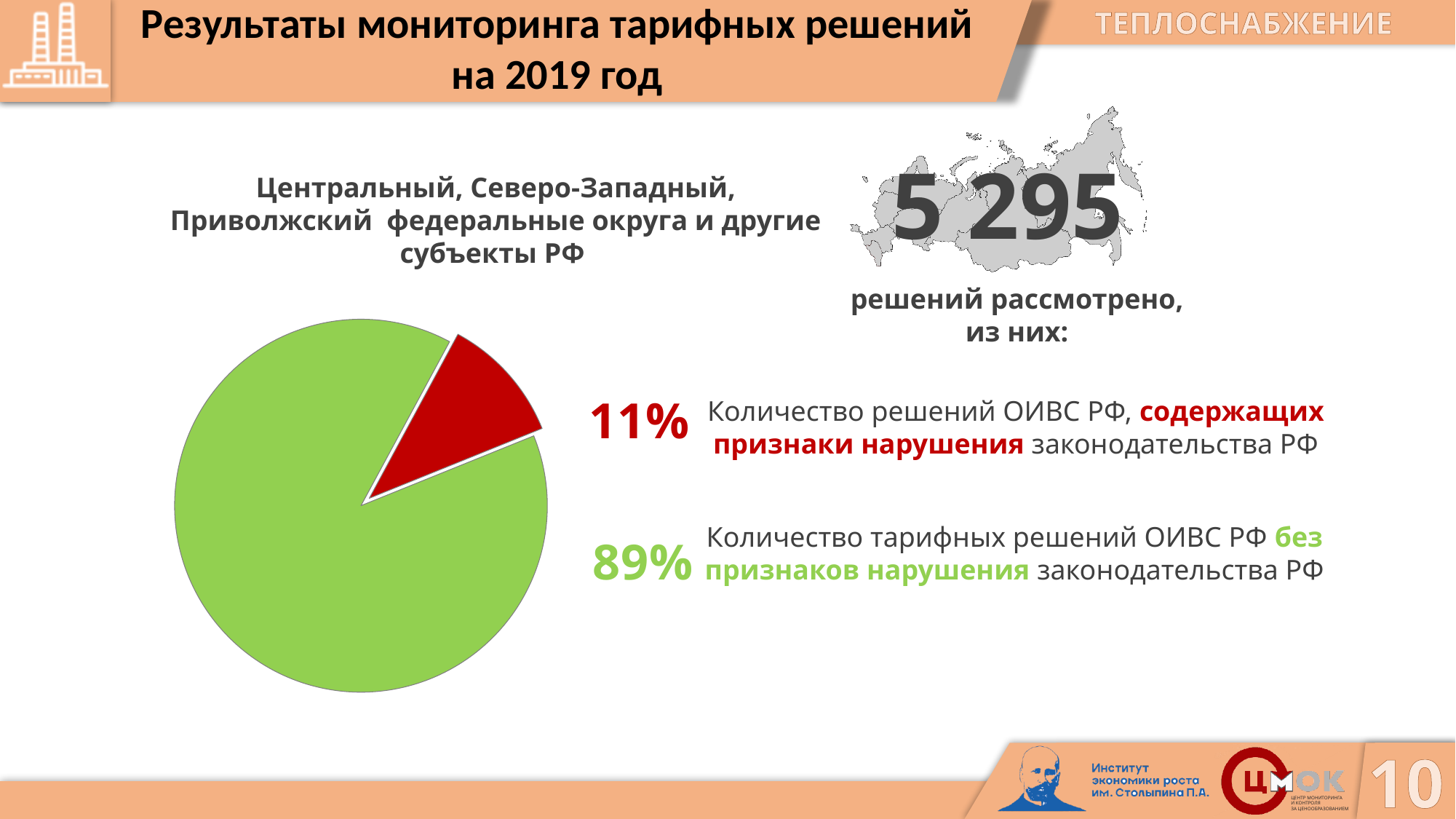
How many slices does the pie chart have? 2 What colour is the slice representing decisions containing signs of violation? red Which is larger: the share of decisions with signs of violation or the share without signs of violation? without signs of violation (89%) What share of the pie chart corresponds to tariff decisions without signs of violation of RF legislation (без признаков нарушения)? 89% Which slice of the pie chart is the smallest? Decisions containing signs of violation (содержащих признаки нарушения), 11% Is the share of decisions containing signs of violation greater or less than 50%? less Which slice of the pie chart is the largest? Decisions without signs of violation (без признаков нарушения), 89% What kind of chart is shown on the slide? pie chart How many tariff decisions were reviewed in total according to the slide? 5 295 What colour is the slice representing decisions without signs of violation? green What share of the pie chart corresponds to decisions containing signs of violation of RF legislation (содержащих признаки нарушения)? 11% What is the difference in percentage points between the share of decisions without signs of violation and the share with signs of violation? 78 percentage points